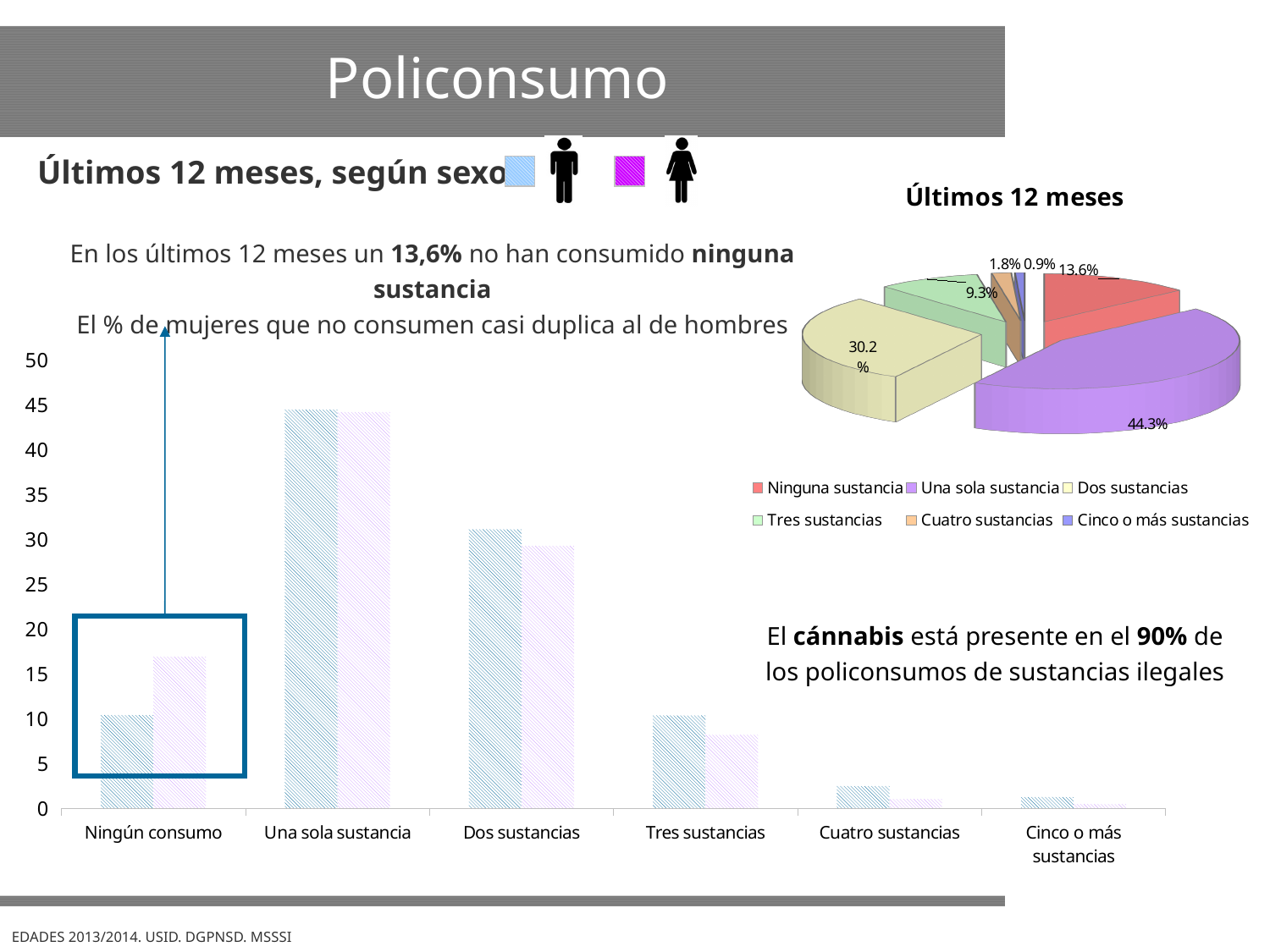
In the bar chart on the left, how many categories are shown on the x axis? 6 In the pie chart titled 'Últimos 12 meses', what is the value for 'Dos sustancias'? 30.2% In the bar chart on the left, for 'Ningún consumo', is the bar for women (magenta) greater or less than 15? greater In the pie chart titled 'Últimos 12 meses', which category has the smallest slice? Cinco o más sustancias In the bar chart on the left, for 'Ningún consumo', which is larger, the bar for men (blue) or the bar for women (magenta)? Women (magenta) In the pie chart titled 'Últimos 12 meses', which category has the largest slice? Una sola sustancia What kind of chart is the chart on the left titled 'Últimos 12 meses, según sexo'? Bar chart In the pie chart titled 'Últimos 12 meses', what is the difference between 'Una sola sustancia' and 'Dos sustancias'? 14.1% In the pie chart titled 'Últimos 12 meses', what is the value for 'Cinco o más sustancias'? 0.9% In the bar chart on the left, which category has the tallest bars? Una sola sustancia In the pie chart titled 'Últimos 12 meses', how many slices are there? 6 In the pie chart titled 'Últimos 12 meses', what is the value for 'Una sola sustancia'? 44.3%